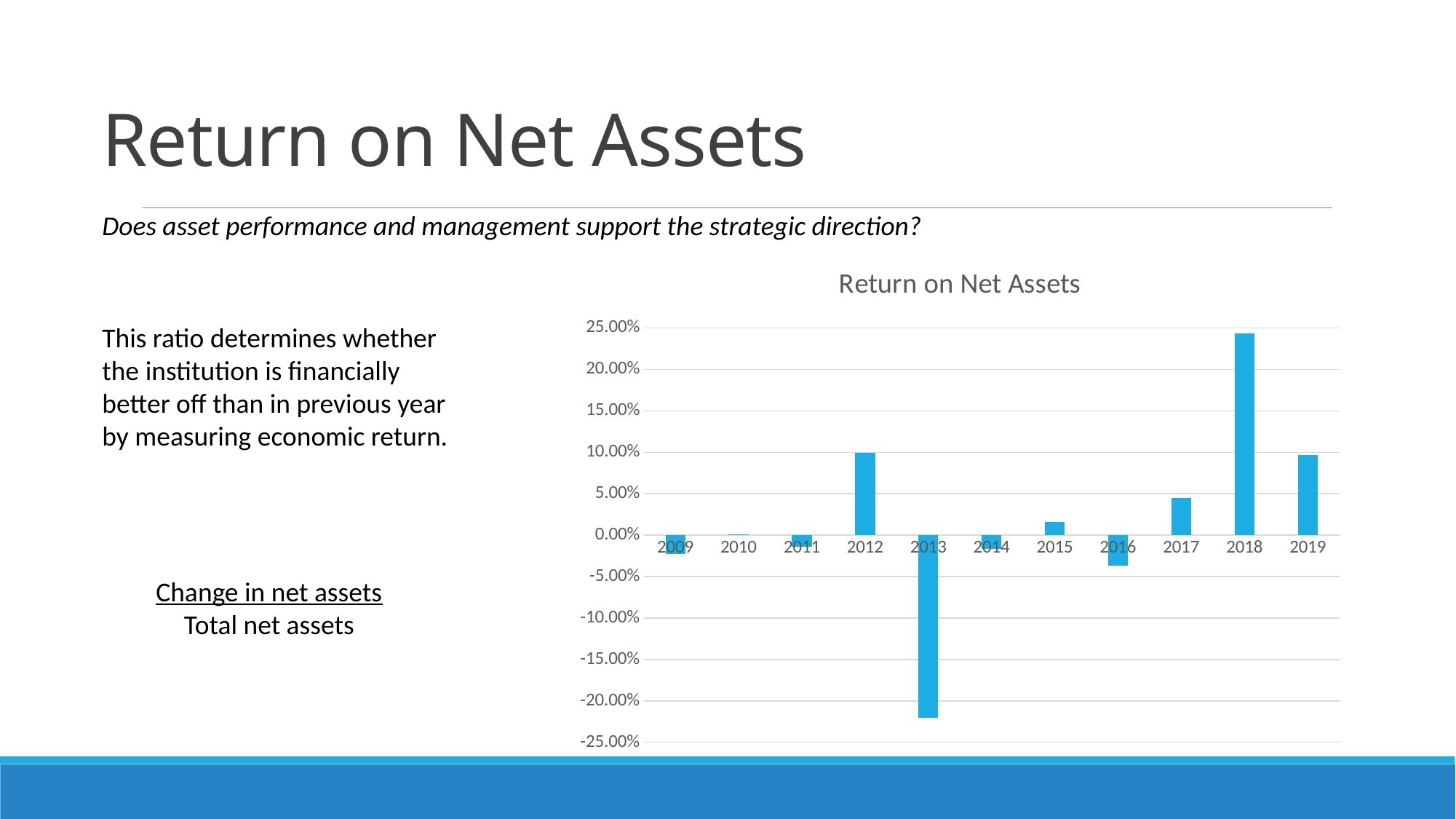
Which is larger, the value for 2018 or the value for 2012? 2018 Which is larger, the value for 2017 or the value for 2015? 2017 Is the value for 2019 greater or less than 5.00%? greater Is the value for 2018 greater or less than 20.00%? greater Which is larger, the value for 2016 or the value for 2013? 2016 Is the value for 2013 greater or less than -20.00%? less Which year has the lowest return on net assets? 2013 What type of chart is shown on the slide? Bar chart Which year has the highest return on net assets? 2018 What is the title of the chart? Return on Net Assets How many years are shown on the x axis of the chart? 11